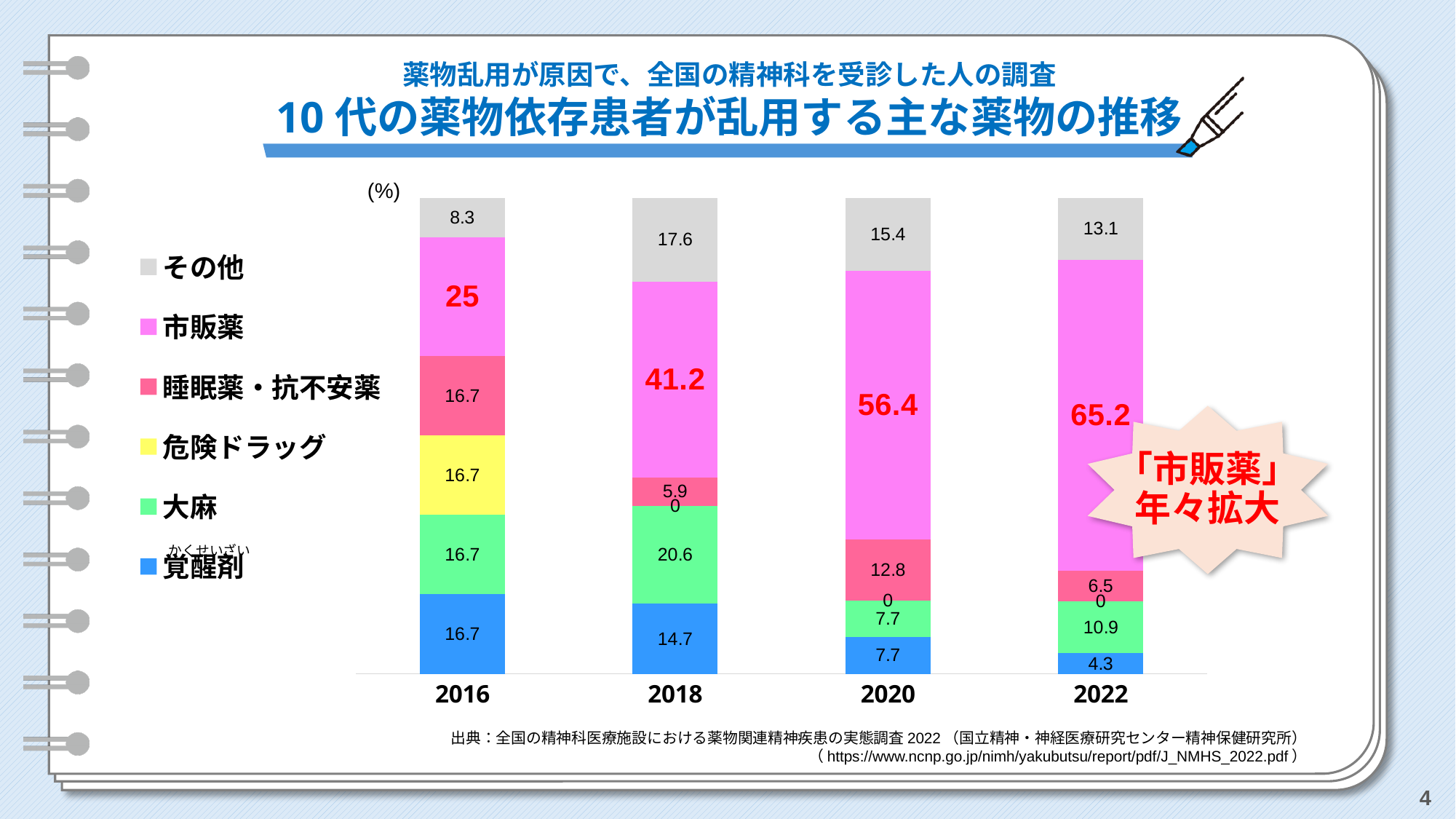
What is the value for 覚醒剤 in 2018? 14.7 What type of chart is shown on the slide? Stacked bar chart What is the value for 睡眠薬・抗不安薬 in 2020? 12.8 What is the difference between the 市販薬 value in 2022 and in 2016? 40.2 Which is larger in 2022: the value for 大麻 or the value for 睡眠薬・抗不安薬? 大麻 What is the value for 市販薬 in 2022? 65.2 How many years (categories) are plotted on the x axis? 4 In which year is the value for 覚醒剤 the lowest? 2022 In which year is the value for 市販薬 the highest? 2022 What is the value for 危険ドラッグ in 2016? 16.7 Does the value for 市販薬 rise or fall from 2016 to 2022? Rise How many series does the legend list? 6